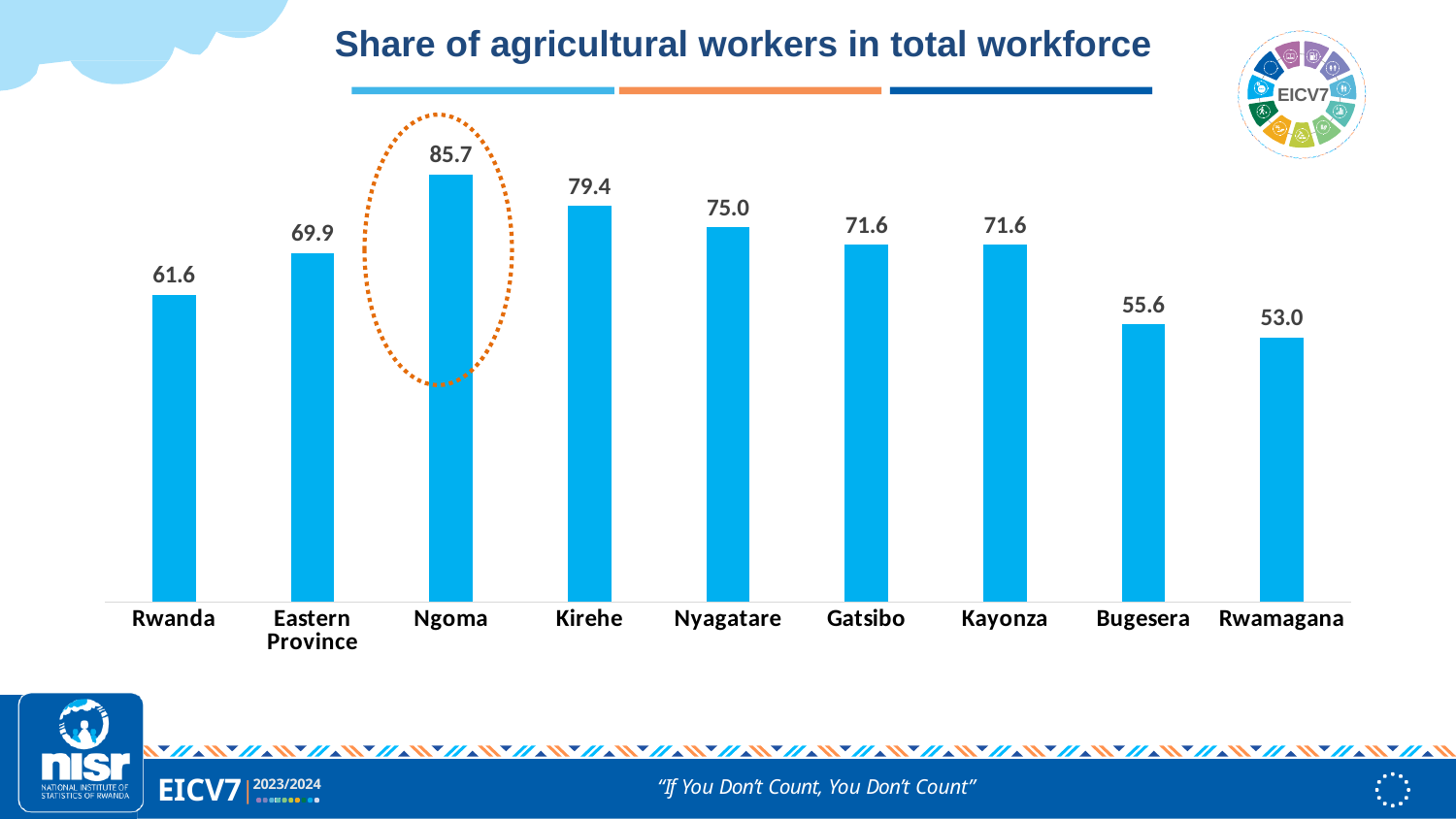
What is the value shown for Bugesera? 55.6 Which category has the highest share of agricultural workers? Ngoma What kind of chart is shown on the slide? Bar chart What is the share of agricultural workers in the total workforce for Ngoma? 85.7 What is the value shown for Rwanda? 61.6 What is the value shown for Eastern Province? 69.9 Which bar is highlighted with a dashed orange circle? Ngoma Which is larger, the value for Kirehe or the value for Gatsibo? Kirehe What is the difference between the values for Kirehe and Nyagatare? 4.4 What is the difference between the values for Ngoma and Rwamagana? 32.7 How many categories are shown on the x axis? 9 Which category has the lowest share of agricultural workers? Rwamagana